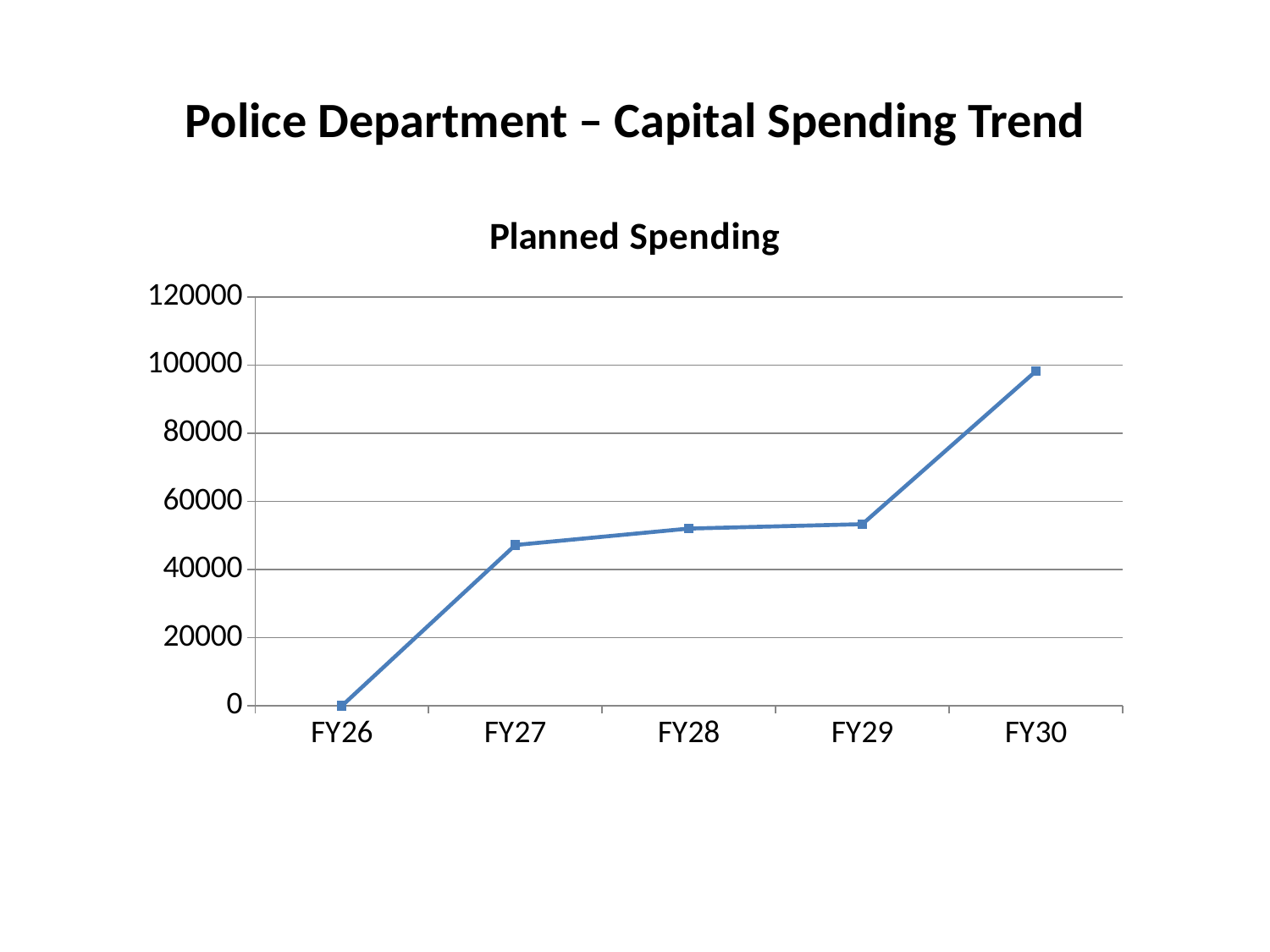
Which fiscal year has the lowest planned spending? FY26 How many fiscal years are plotted on the x axis? 5 Which has higher planned spending, FY27 or FY30? FY30 Is the planned spending for FY29 greater or less than 60000? less Is the planned spending for FY28 greater or less than 40000? greater Do the planned spending values rise or fall from FY26 to FY30? rise What is the planned spending value for FY26? 0 Is the planned spending for FY30 greater or less than 80000? greater What is the title of the chart? Planned Spending Which fiscal year has the highest planned spending? FY30 What type of chart is shown on the slide? line chart